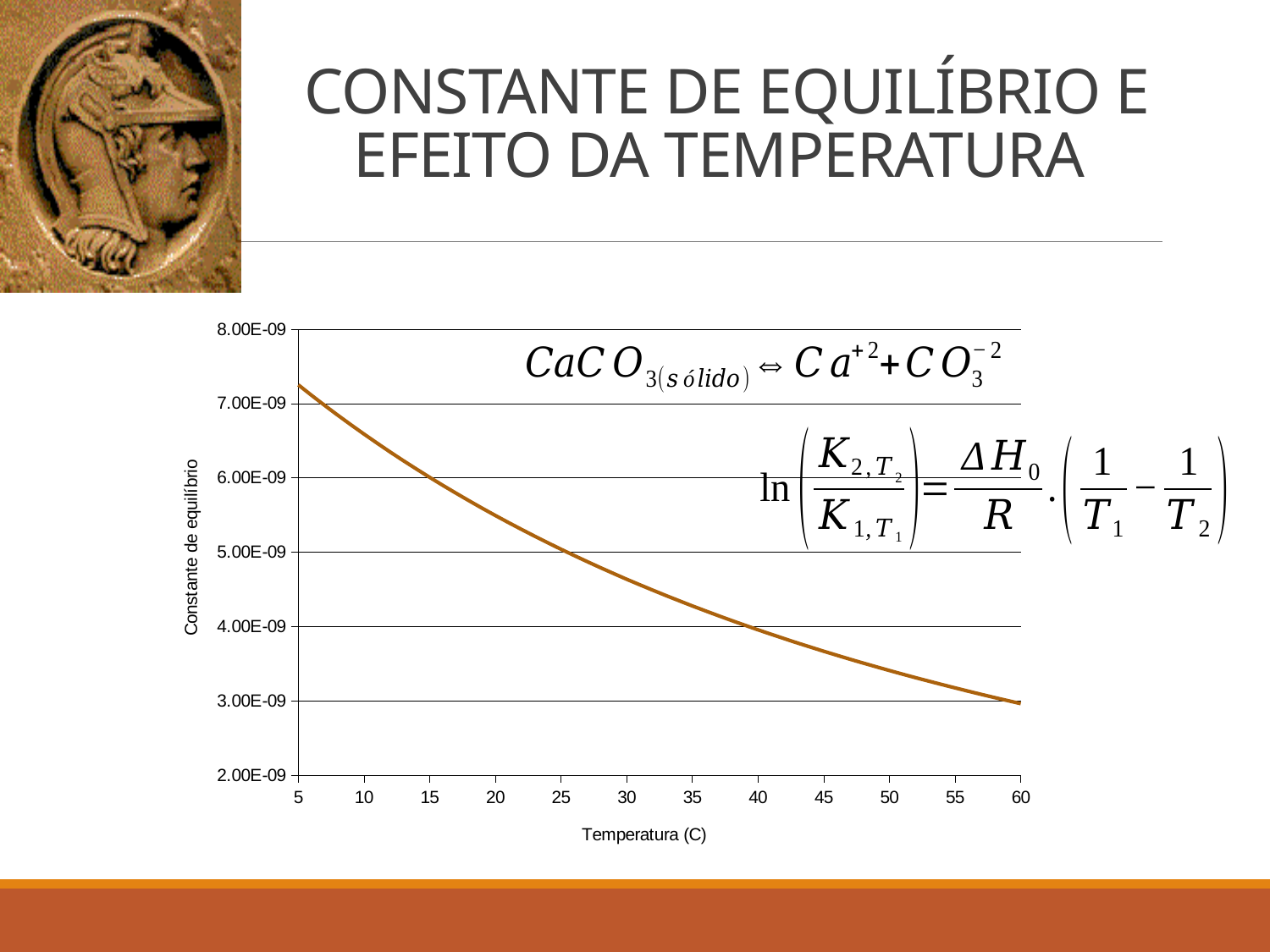
Is the equilibrium constant at a temperature of 50 C greater or less than 4.00E-09? less What is the label of the x axis? Temperatura (C) Is the equilibrium constant at a temperature of 30 C greater or less than 4.00E-09? greater What kind of chart is shown on the slide? line chart Is the equilibrium constant at a temperature of 10 C greater or less than 6.00E-09? greater At which temperature on the x axis is the equilibrium constant highest? 5 Does the equilibrium constant rise or fall as temperature increases along the x axis? fall Which temperature has the larger equilibrium constant, 10 C or 50 C? 10 C What is the label of the y axis? Constante de equilíbrio